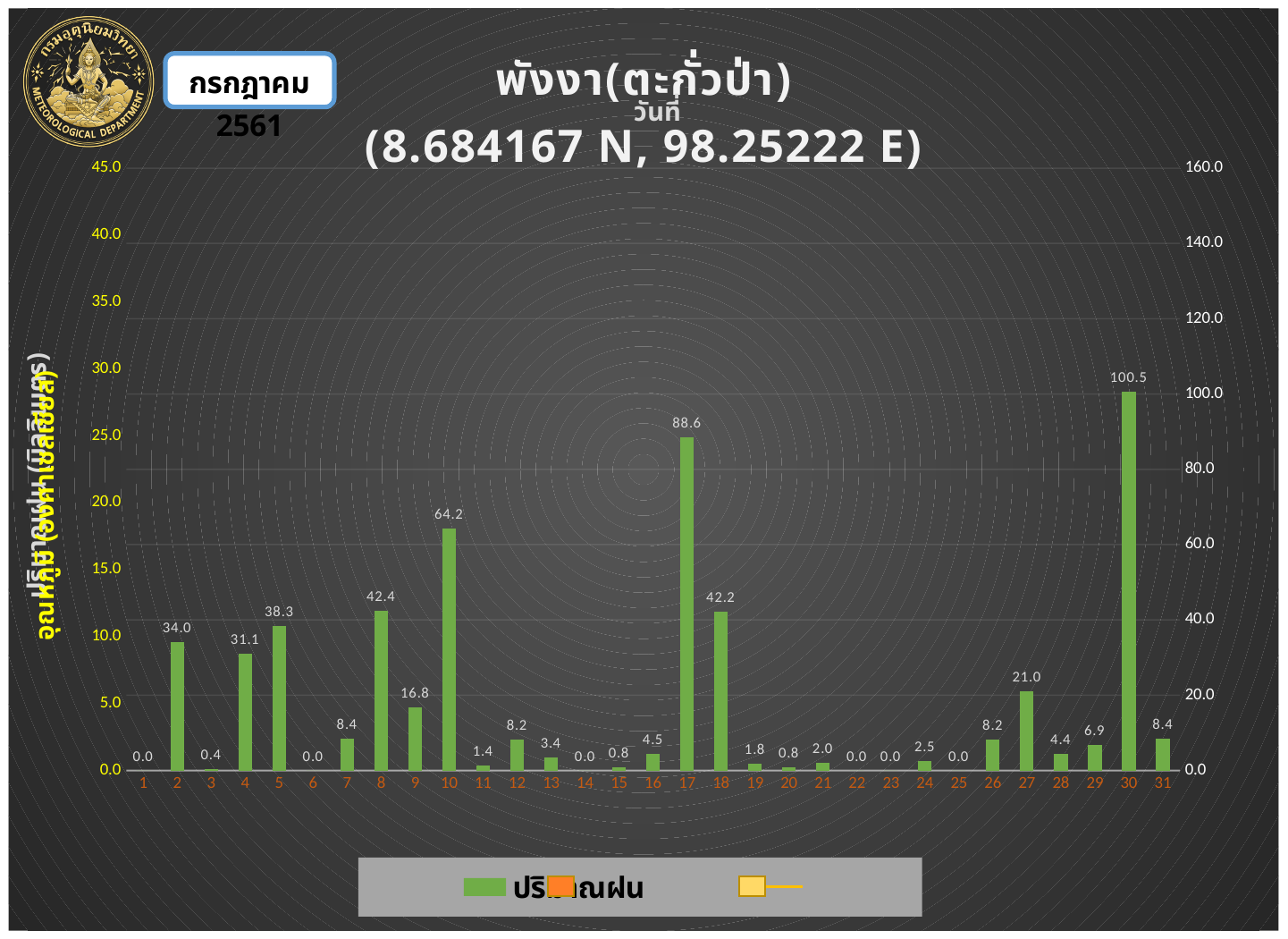
What is the rainfall value for day 17? 88.6 Which has a larger rainfall value, day 5 or day 4? day 5 Which has a larger rainfall value, day 9 or day 27? day 27 Which day has the highest rainfall value? 30 What is the rainfall value for day 10? 64.2 What kind of chart is shown on the slide? bar chart What is the rainfall value for day 30? 100.5 What is the rainfall value for day 27? 21.0 How many days are shown on the x axis? 31 What coordinates are given in the chart title? 8.684167 N, 98.25222 E What is the difference between the rainfall values for day 30 and day 17? 11.9 What is the difference between the rainfall values for day 8 and day 18? 0.2